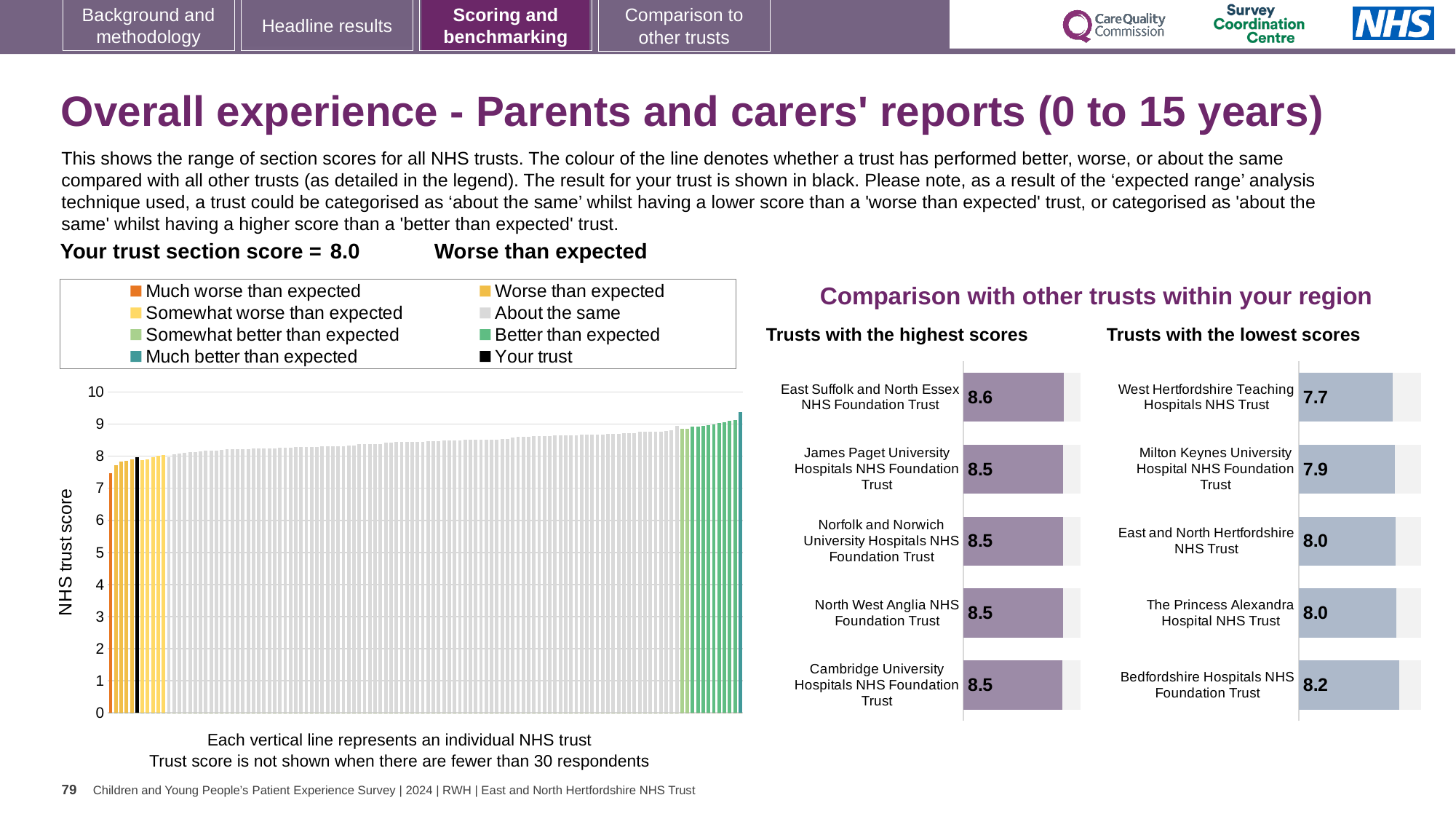
How many entries does the legend of the NHS trust score chart list? 8 How many trusts are shown in the 'Trusts with the highest scores' chart? 5 In the 'Trusts with the lowest scores' chart, what is the score for West Hertfordshire Teaching Hospitals NHS Trust? 7.7 In the 'Trusts with the lowest scores' chart, which has the higher score: Milton Keynes University Hospital NHS Foundation Trust or Bedfordshire Hospitals NHS Foundation Trust? Bedfordshire Hospitals NHS Foundation Trust In the 'Trusts with the highest scores' chart, what is the score for East Suffolk and North Essex NHS Foundation Trust? 8.6 In the 'Trusts with the lowest scores' chart, what is the score for East and North Hertfordshire NHS Trust? 8.0 In the 'Trusts with the lowest scores' chart, which trust has the lowest score? West Hertfordshire Teaching Hospitals NHS Trust In the NHS trust score chart on the left, do the values rise or fall from left to right? Rise In the 'Trusts with the lowest scores' chart, what is the difference between the scores of Bedfordshire Hospitals NHS Foundation Trust and West Hertfordshire Teaching Hospitals NHS Trust? 0.5 What kind of chart is the NHS trust score chart on the left? Bar chart In the NHS trust score chart on the left, what colour is the bar for 'Your trust'? Black In the 'Trusts with the highest scores' chart, which trust has the highest score? East Suffolk and North Essex NHS Foundation Trust